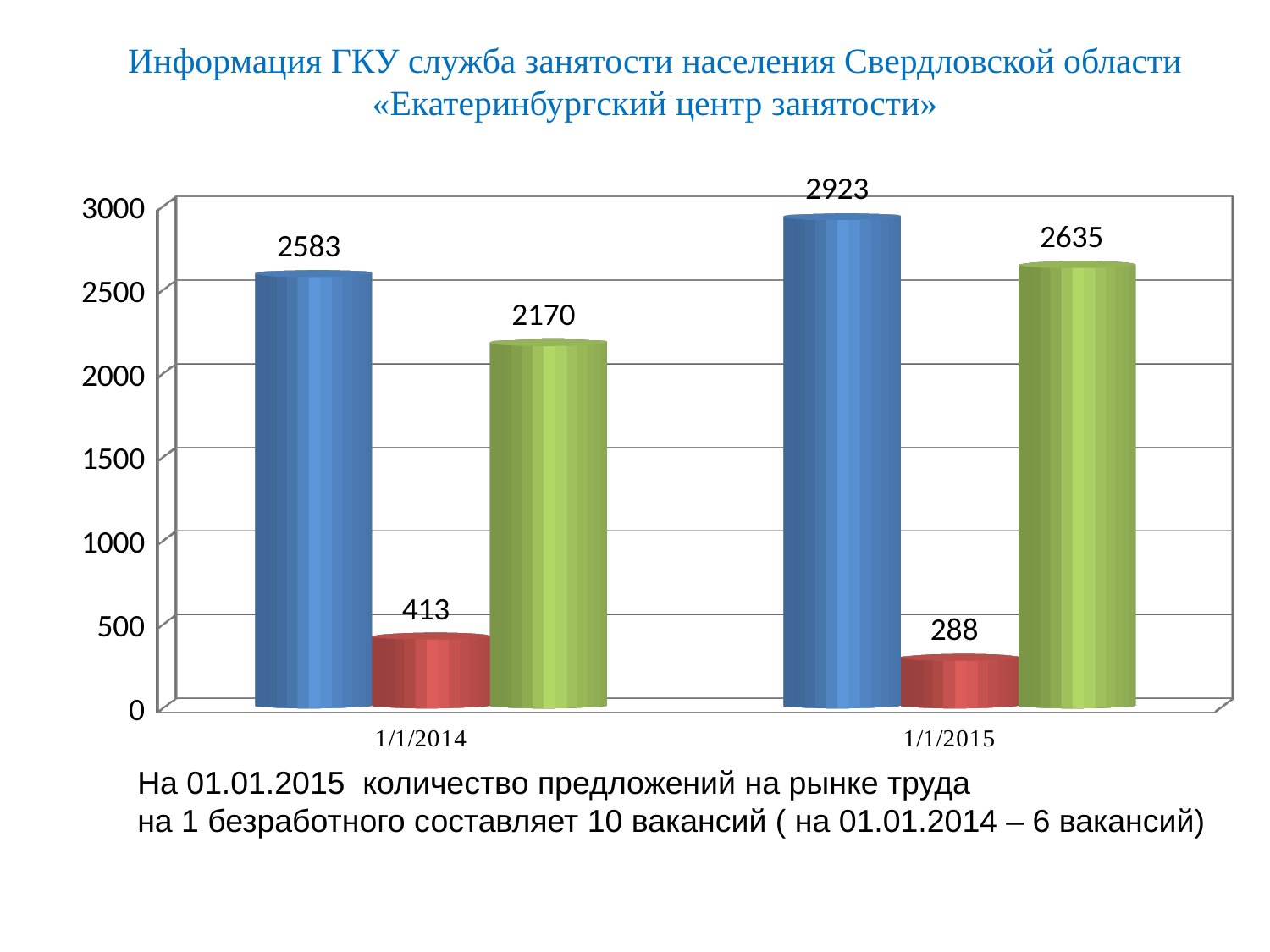
Which bar has the lowest value on the chart? The red bar for 1/1/2015 (288) What is the value of the red bar for 1/1/2015? 288 What is the value of the green bar for 1/1/2014? 2170 What is the difference between the blue bar values for 1/1/2015 and 1/1/2014? 340 What is the difference between the red bar values for 1/1/2014 and 1/1/2015? 125 What is the value of the green bar for 1/1/2015? 2635 What kind of chart is shown on the slide? Bar chart How many categories are shown on the x axis? 2 Does the red bar rise or fall from 1/1/2014 to 1/1/2015? Fall Which is larger: the green bar for 1/1/2014 or the green bar for 1/1/2015? The green bar for 1/1/2015 Which bar has the highest value on the chart? The blue bar for 1/1/2015 (2923) What is the value of the blue bar for 1/1/2014? 2583